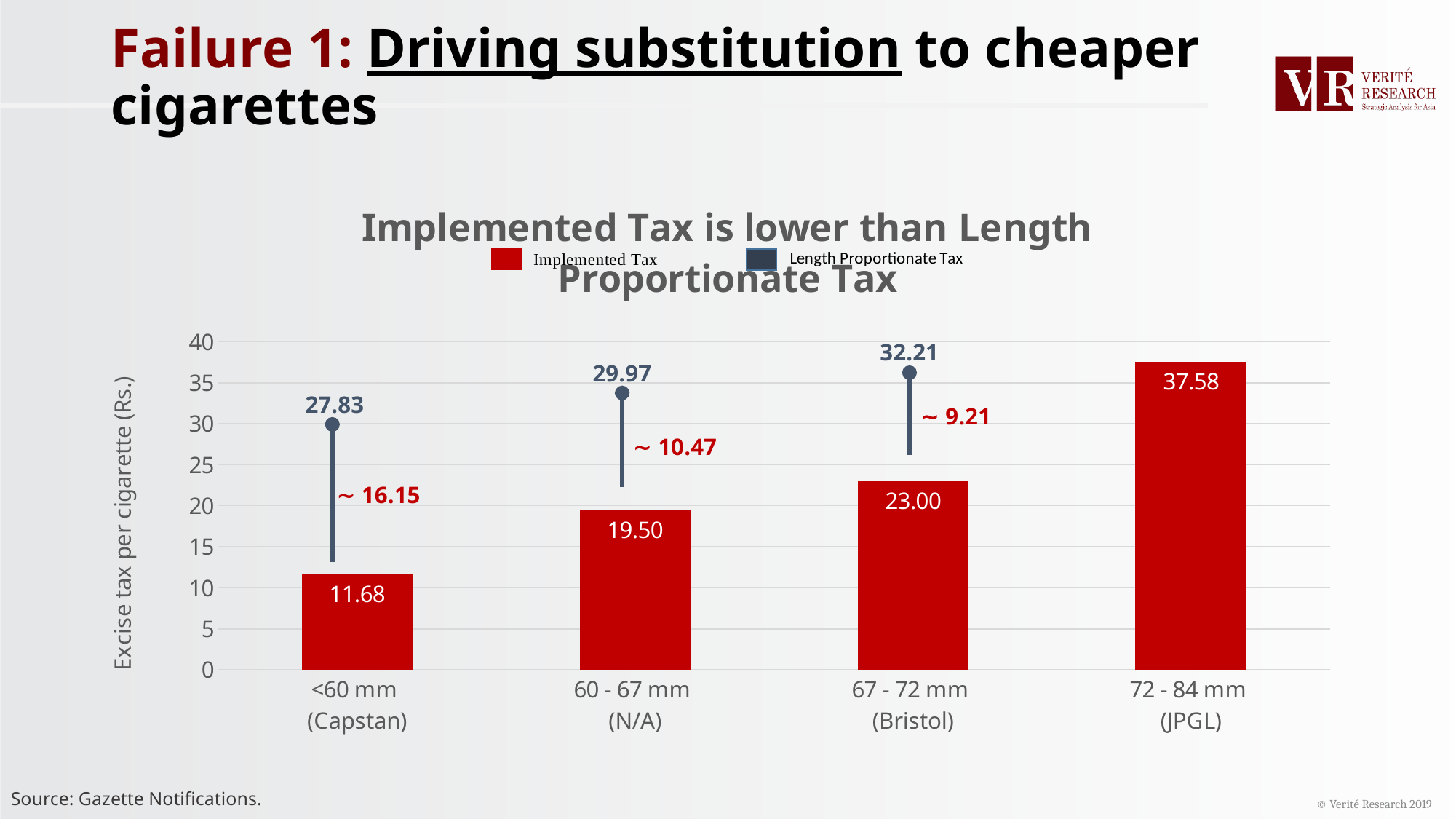
What is the Implemented Tax for the 72 - 84 mm (JPGL) category? 37.58 How many series does the legend list? 2 Which category has the highest Implemented Tax? 72 - 84 mm (JPGL) Which has a higher Implemented Tax, 60 - 67 mm (N/A) or 67 - 72 mm (Bristol)? 67 - 72 mm (Bristol) How many cigarette length categories are shown on the x axis? 4 What kind of chart is shown on the slide? bar chart What is the difference between the Implemented Tax for 72 - 84 mm (JPGL) and for 67 - 72 mm (Bristol)? 14.58 Is the Length Proportionate Tax for 60 - 67 mm (N/A) greater or less than 25? greater Which category has the lowest Implemented Tax? <60 mm (Capstan) What is the difference between the Length Proportionate Tax and the Implemented Tax for the 60 - 67 mm (N/A) category? 10.47 What is the Implemented Tax for the <60 mm (Capstan) category? 11.68 What is the Length Proportionate Tax for the 67 - 72 mm (Bristol) category? 32.21